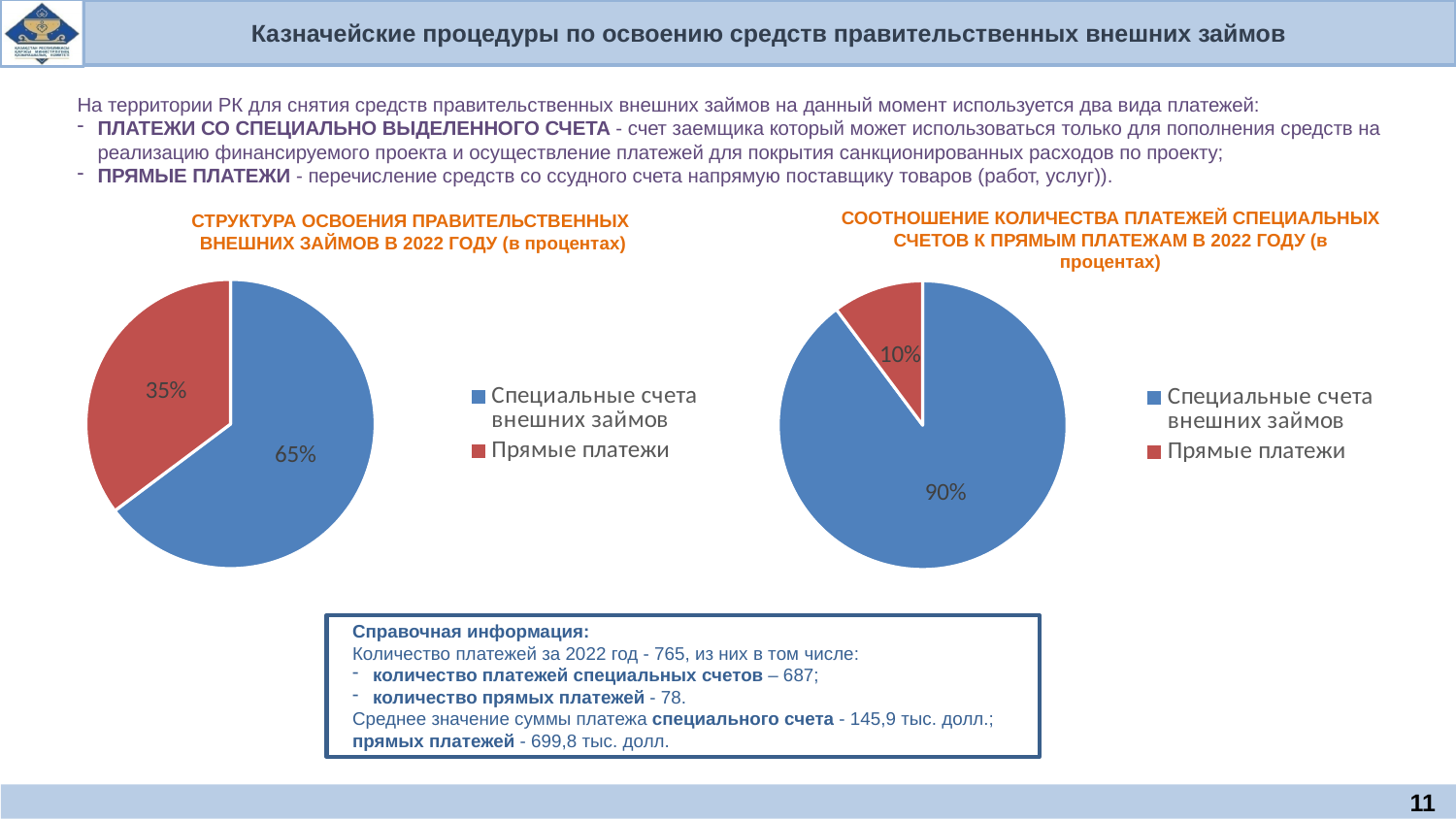
In the left pie chart (СТРУКТУРА ОСВОЕНИЯ ПРАВИТЕЛЬСТВЕННЫХ ВНЕШНИХ ЗАЙМОВ В 2022 ГОДУ), what share is shown for Прямые платежи? 35% In the left pie chart, what is the difference in percentage points between Специальные счета внешних займов and Прямые платежи? 30 percentage points In the right pie chart (СООТНОШЕНИЕ КОЛИЧЕСТВА ПЛАТЕЖЕЙ СПЕЦИАЛЬНЫХ СЧЕТОВ К ПРЯМЫМ ПЛАТЕЖАМ В 2022 ГОДУ), what share is shown for Специальные счета внешних займов? 90% In the right pie chart, which category has the smallest slice? Прямые платежи In the right pie chart, what is the difference in percentage points between Специальные счета внешних займов and Прямые платежи? 80 percentage points How many categories does the legend of the right pie chart list? 2 In the left pie chart, what colour is the slice for Прямые платежи? Red In the left pie chart, which category has the largest slice? Специальные счета внешних займов In the left pie chart (СТРУКТУРА ОСВОЕНИЯ ПРАВИТЕЛЬСТВЕННЫХ ВНЕШНИХ ЗАЙМОВ В 2022 ГОДУ), what share is shown for Специальные счета внешних займов? 65% Is the share of Прямые платежи larger in the left pie chart or in the right pie chart? Left pie chart What type of chart is used on the left side of the slide? Pie chart In the right pie chart (СООТНОШЕНИЕ КОЛИЧЕСТВА ПЛАТЕЖЕЙ СПЕЦИАЛЬНЫХ СЧЕТОВ К ПРЯМЫМ ПЛАТЕЖАМ В 2022 ГОДУ), what share is shown for Прямые платежи? 10%